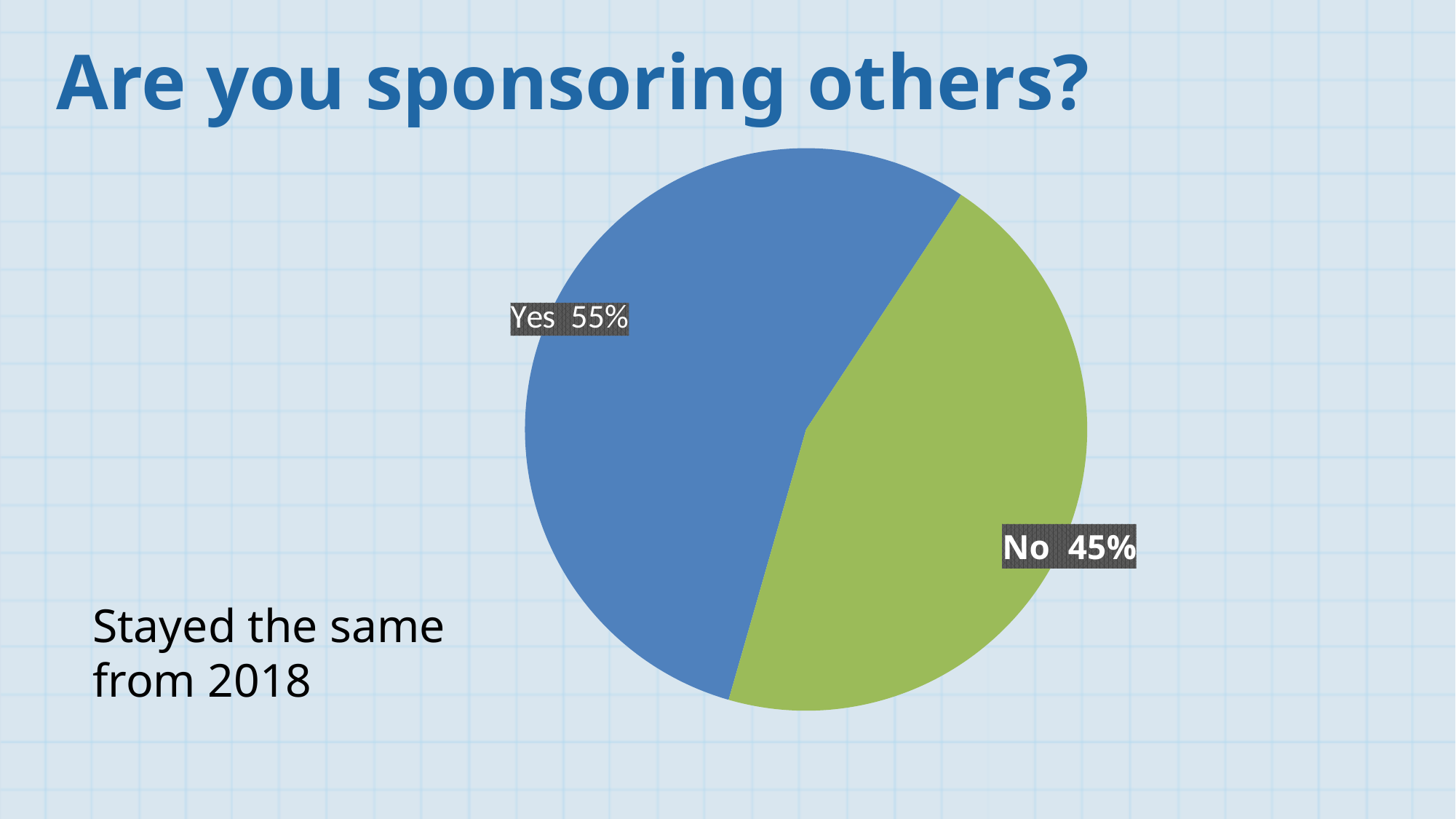
What is the title of the slide containing the chart? Are you sponsoring others? What colour is the Yes slice? blue Which is larger, the Yes slice or the No slice? Yes What share of the pie does the No slice represent? 45% What kind of chart is shown on the slide? pie chart How many slices does the pie chart have? 2 What percentage of respondents answered Yes? 55% Which slice is the smallest? No Which slice is the largest? Yes What percentage of respondents answered No? 45% What is the difference between the Yes and No percentages? 10%